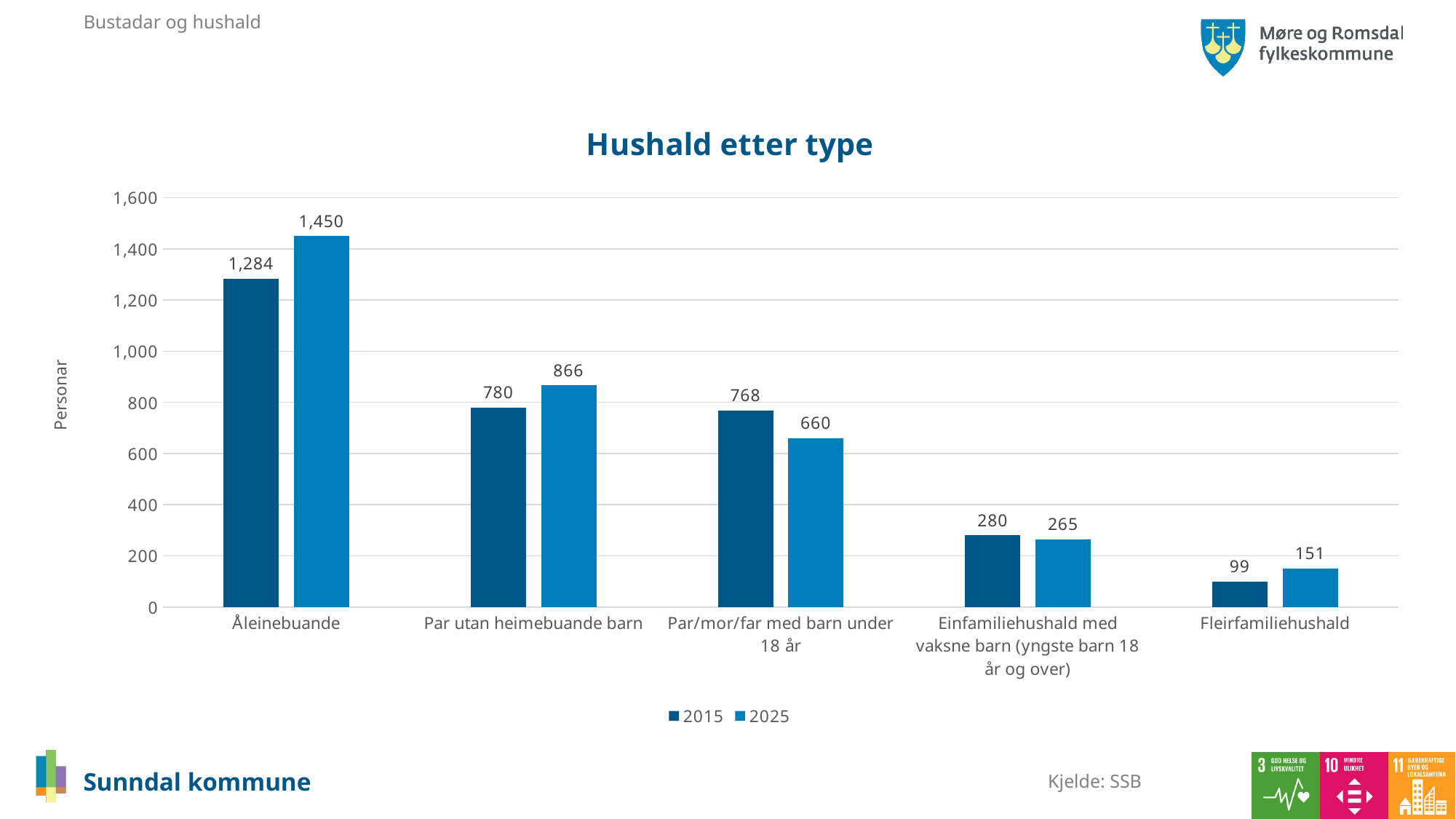
How many series does the legend list? 2 Is the 2015 value for Einfamiliehushald med vaksne barn (yngste barn 18 år og over) greater or less than 400? less How many household categories are shown on the x axis? 5 What is the value for Par/mor/far med barn under 18 år in 2015? 768 What kind of chart is shown? bar chart Which is larger for Par utan heimebuande barn: the 2015 value or the 2025 value? 2025 Which category has the highest value in 2015? Åleinebuande What is the value for Åleinebuande in 2025? 1,450 What is the difference between the 2015 and 2025 values for Par/mor/far med barn under 18 år? 108 What is the value for Fleirfamiliehushald in 2025? 151 What is the difference between the 2025 and 2015 values for Åleinebuande? 166 Which category has the lowest value in 2025? Fleirfamiliehushald